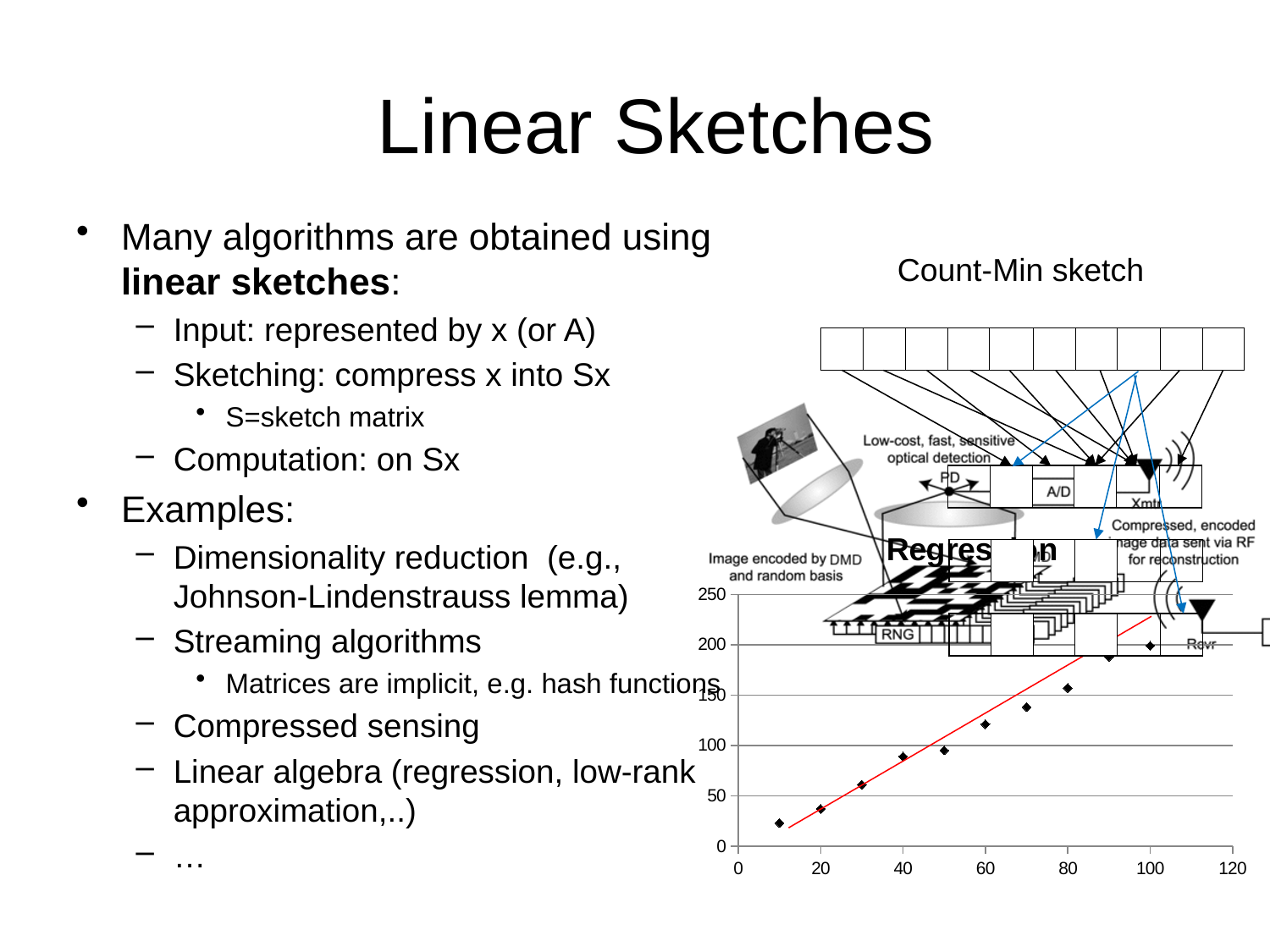
In the "Regression" chart, do the plotted values rise or fall as x increases? rise In the "Regression" chart, is the value at x = 70 greater or less than 150? less In the "Regression" chart, is the value at x = 60 greater or less than 100? greater What is the highest value shown on the x axis of the "Regression" chart? 120 How many data points are plotted in the "Regression" chart? 10 In the "Regression" chart, which x value has the lowest plotted value? 10 In the "Regression" chart, is the value at x = 10 greater or less than 50? less In the "Regression" chart, is the value at x = 90 larger than the value at x = 50? yes What is the highest value shown on the y axis of the "Regression" chart? 250 What kind of chart is the chart titled "Regression"? scatter chart